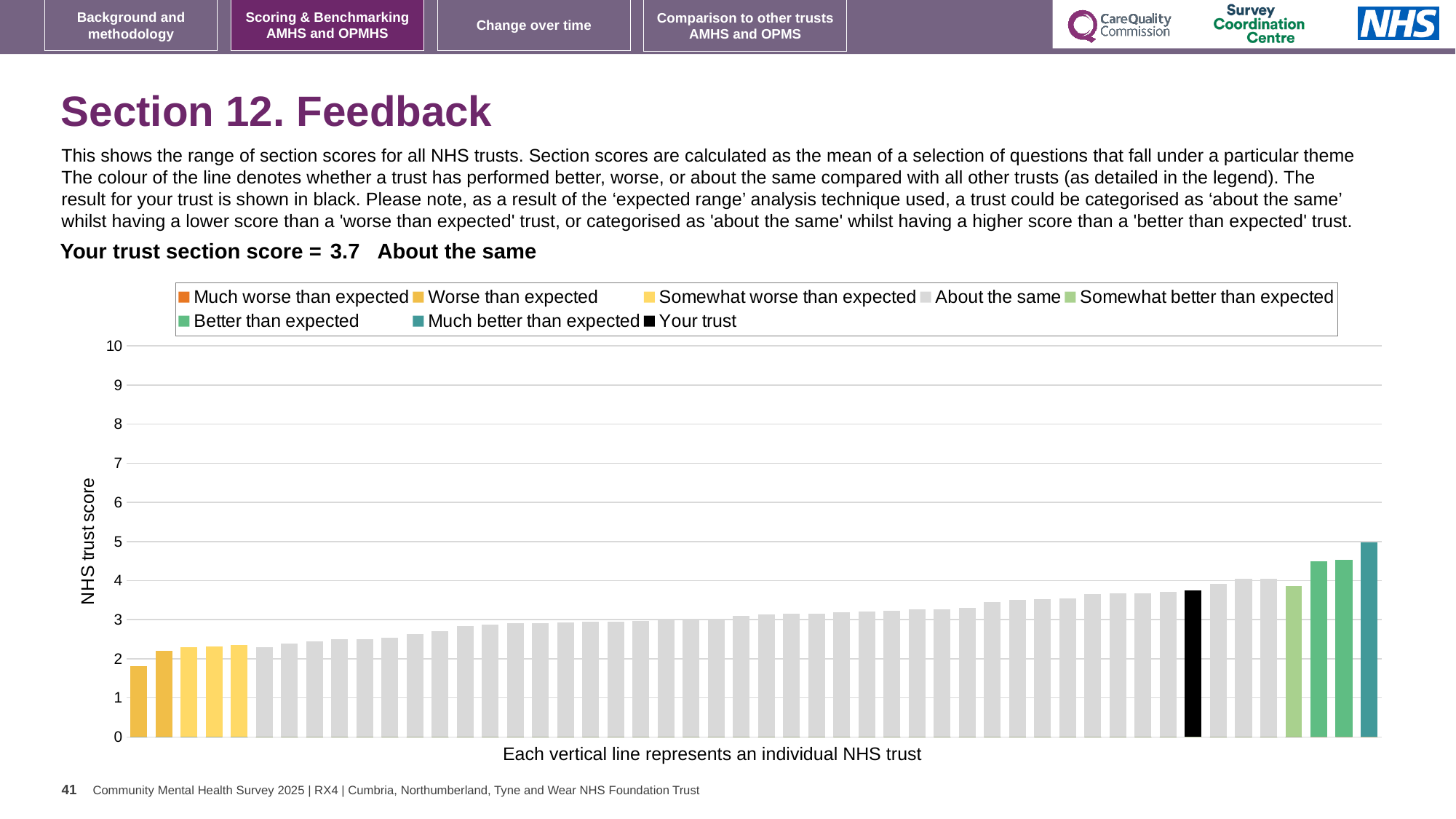
What is the label on the vertical axis of the chart? NHS trust score Which benchmarking category is your trust placed in for Section 12. Feedback? About the same Is the value of the black 'Your trust' bar greater or less than 3? greater What colour is used for the 'Your trust' bar in the chart? black How many bars are coloured as 'Better than expected' (mid green)? 2 How many entries does the chart legend list? 8 Is the value of the tallest bar in the chart greater or less than 4? greater What kind of chart is shown on the slide? bar chart What is the section score for your trust shown on the slide? 3.7 Is the value of the shortest bar in the chart greater or less than 2? less Do the bar values rise or fall moving from left to right along the x axis? rise Which legend category does the tallest bar (the teal bar at the far right) belong to? Much better than expected